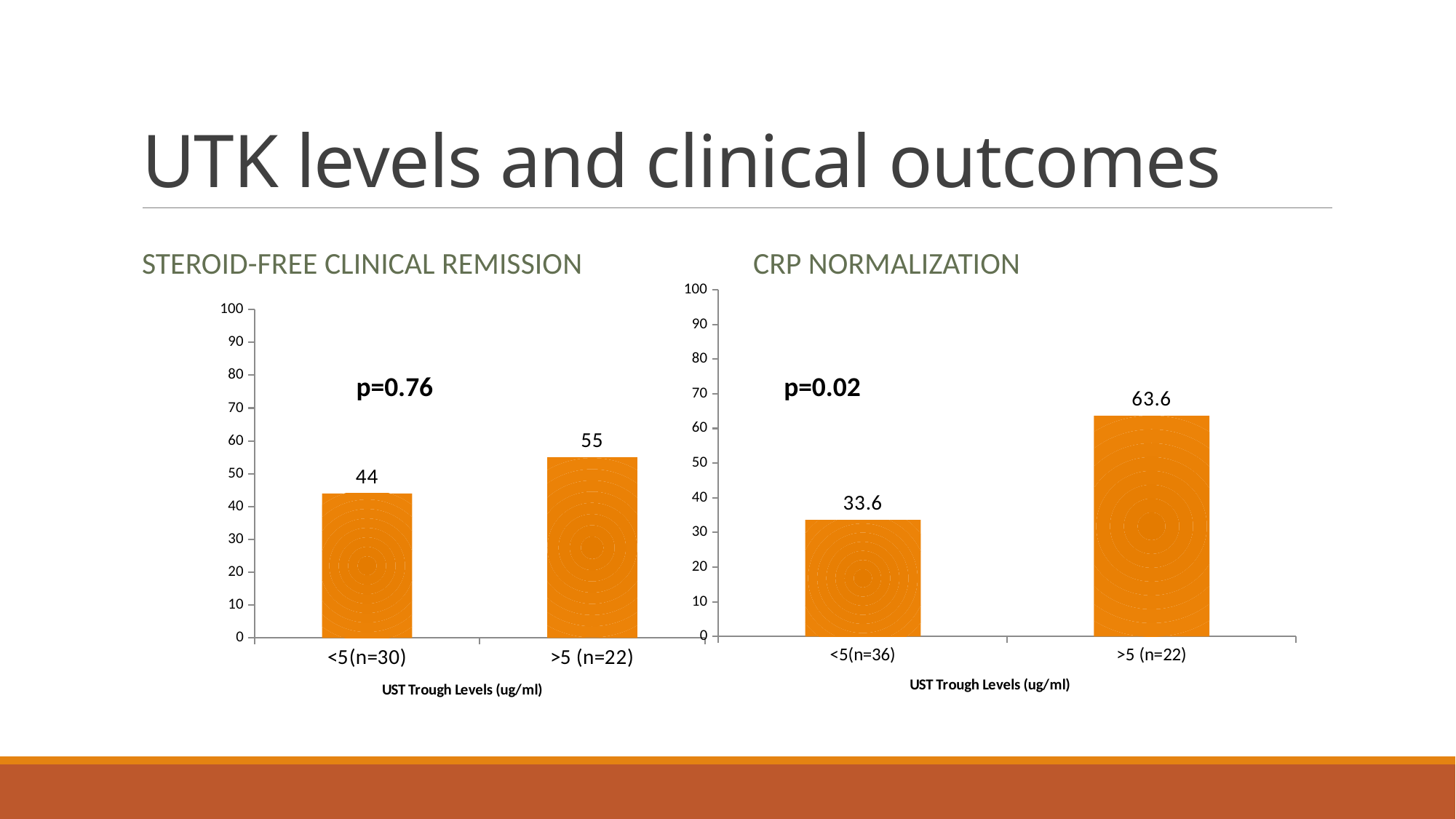
In the CRP Normalization chart, which category has the highest value? >5 (n=22) In the Steroid-Free Clinical Remission chart, what is the value for >5 (n=22)? 55 In the Steroid-Free Clinical Remission chart, what is the difference between the >5 (n=22) and <5 (n=30) values? 11 How many categories are shown in the Steroid-Free Clinical Remission chart? 2 In the CRP Normalization chart, what is the value for >5 (n=22)? 63.6 In the CRP Normalization chart, what is the difference between the >5 (n=22) and <5 (n=36) values? 30 In the Steroid-Free Clinical Remission chart, what is the value for <5 (n=30)? 44 What kind of chart is the CRP Normalization chart? Bar chart In the Steroid-Free Clinical Remission chart, which category has the lowest value? <5 (n=30) In the CRP Normalization chart, what is the value for <5 (n=36)? 33.6 What p-value is shown on the CRP Normalization chart? p=0.02 In the CRP Normalization chart, which is larger: the value for <5 (n=36) or >5 (n=22)? >5 (n=22)